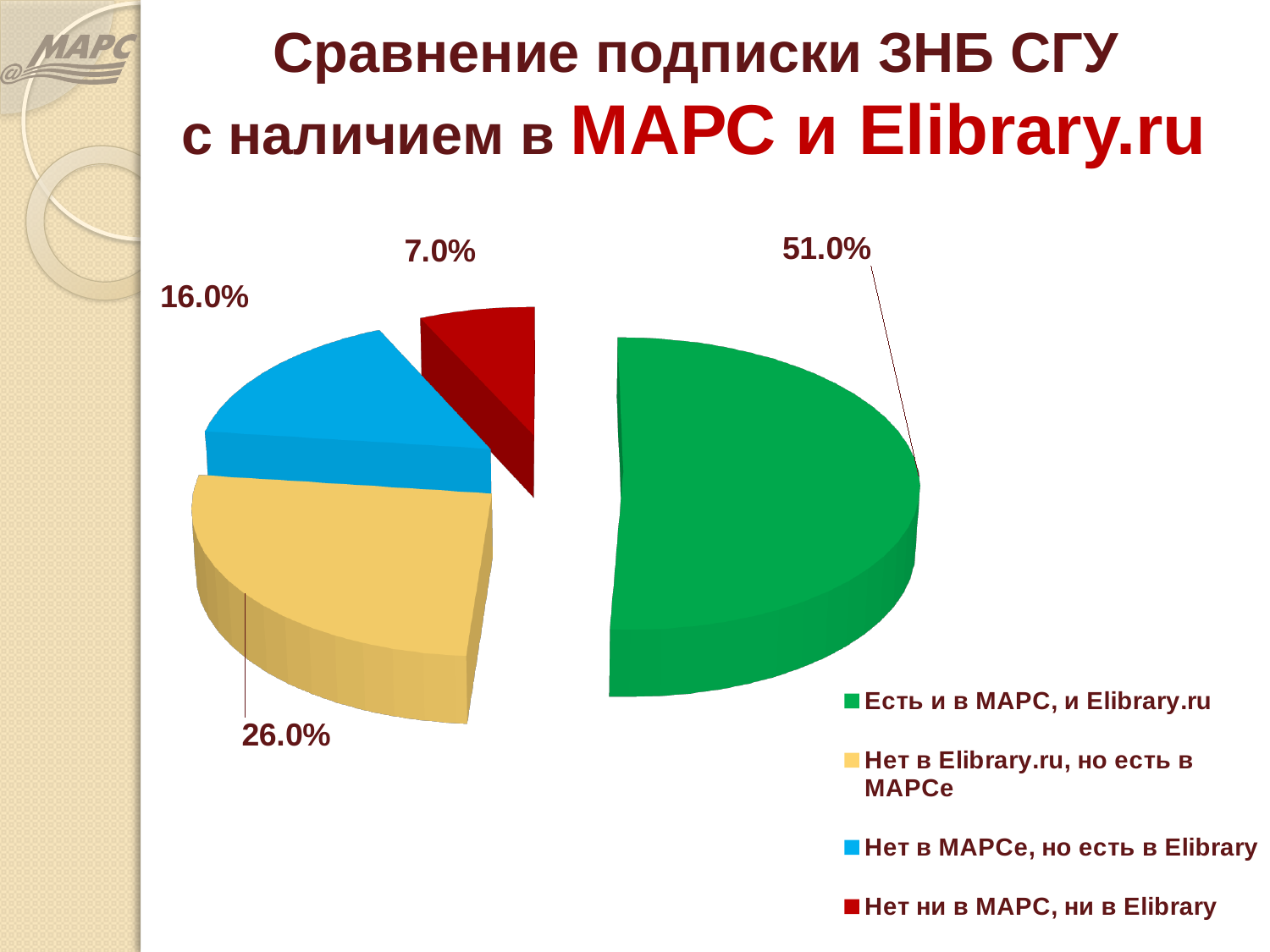
How many entries does the legend list? 4 What share of the pie is labelled "Нет в Elibrary.ru, но есть в МАРСе"? 26.0% What kind of chart is shown on the slide? Pie chart What colour is the slice representing "Нет ни в МАРС, ни в Elibrary"? Red How many slices does the pie chart have? 4 What share of the pie is labelled "Нет в МАРСе, но есть в Elibrary"? 16.0% Which category has the largest slice of the pie? Есть и в МАРС, и Elibrary.ru Which is larger: the "Нет в МАРСе, но есть в Elibrary" slice or the "Нет ни в МАРС, ни в Elibrary" slice? Нет в МАРСе, но есть в Elibrary What is the difference in percentage points between the "Есть и в МАРС, и Elibrary.ru" slice and the "Нет в Elibrary.ru, но есть в МАРСе" slice? 25.0% Which category has the smallest slice of the pie? Нет ни в МАРС, ни в Elibrary What share of the pie is labelled "Нет ни в МАРС, ни в Elibrary"? 7.0% What share of the pie is labelled "Есть и в МАРС, и Elibrary.ru"? 51.0%